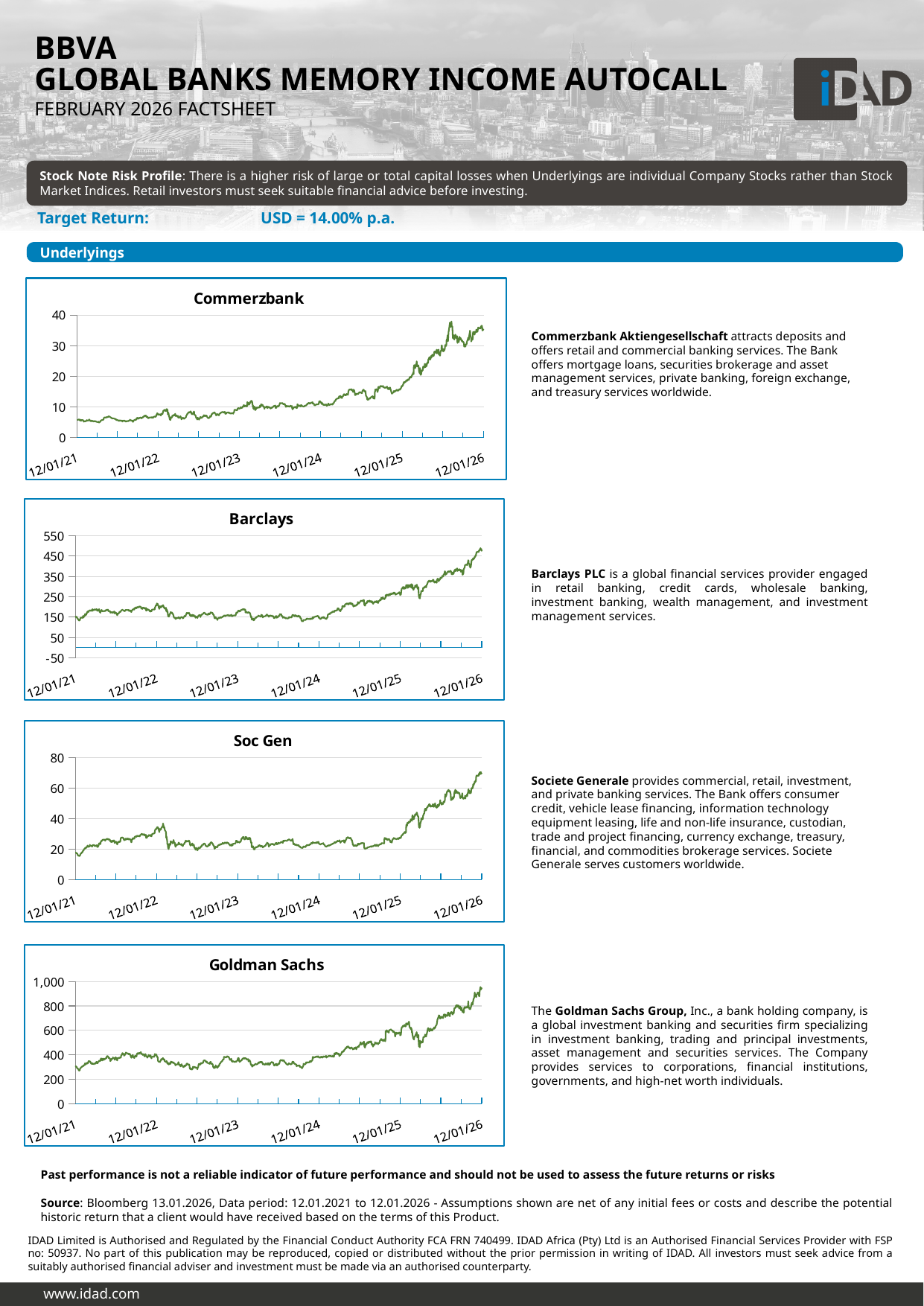
What is the title of the third chart from the top on the slide? Soc Gen In the Goldman Sachs chart, is the value at the start of the series (12/01/21) greater or less than 200? greater In the Barclays chart, does the line overall rise or fall from 12/01/21 to 12/01/26? rise How many charts are shown in the Underlyings section of the slide? 4 In the Goldman Sachs chart, is the value at the end of the series (around 12/01/26) greater or less than 800? greater In the Soc Gen chart, is the value at the end of the series (around 12/01/26) greater or less than 60? greater What kind of chart is the Commerzbank chart? line chart What is the highest value shown on the y axis of the Goldman Sachs chart? 1,000 In the Soc Gen chart, does the line overall rise or fall from 12/01/21 to 12/01/26? rise